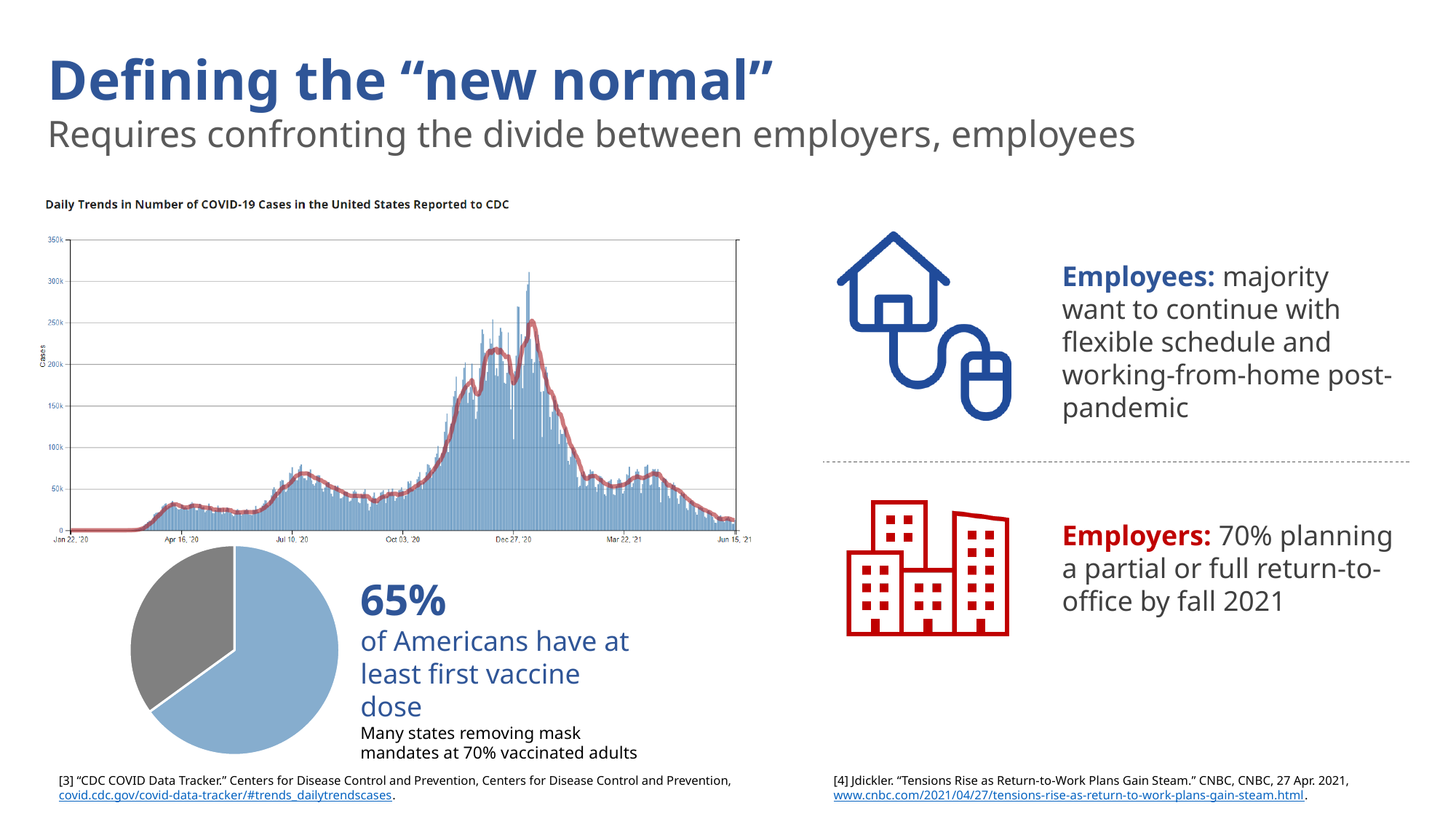
In the Daily Trends in Number of COVID-19 Cases chart, is the value around Apr 16, '20 greater or less than 50k? less In the Daily Trends in Number of COVID-19 Cases chart, what is the highest value shown on the y axis? 350k In the Daily Trends in Number of COVID-19 Cases chart, near which x-axis date do cases reach their highest level? Dec 27, '20 What kind of chart is shown in the lower left of the slide next to the 65% figure? pie chart What is the title of the chart in the upper left of the slide? Daily Trends in Number of COVID-19 Cases in the United States Reported to CDC In the Daily Trends in Number of COVID-19 Cases chart, what is the first date shown on the x axis? Jan 22, '20 In the Daily Trends in Number of COVID-19 Cases chart, what is the last date shown on the x axis? Jun 15, '21 In the Daily Trends in Number of COVID-19 Cases chart, do cases rise or fall between Mar 22, '21 and Jun 15, '21? fall In the pie chart in the lower left, what share of the pie does the blue slice represent? 65% In the Daily Trends in Number of COVID-19 Cases chart, is the peak daily value greater or less than 200k? greater In the Daily Trends in Number of COVID-19 Cases chart, what is the label on the y axis? Cases In the Daily Trends in Number of COVID-19 Cases chart, is the value around Jul 10, '20 greater or less than 100k? less